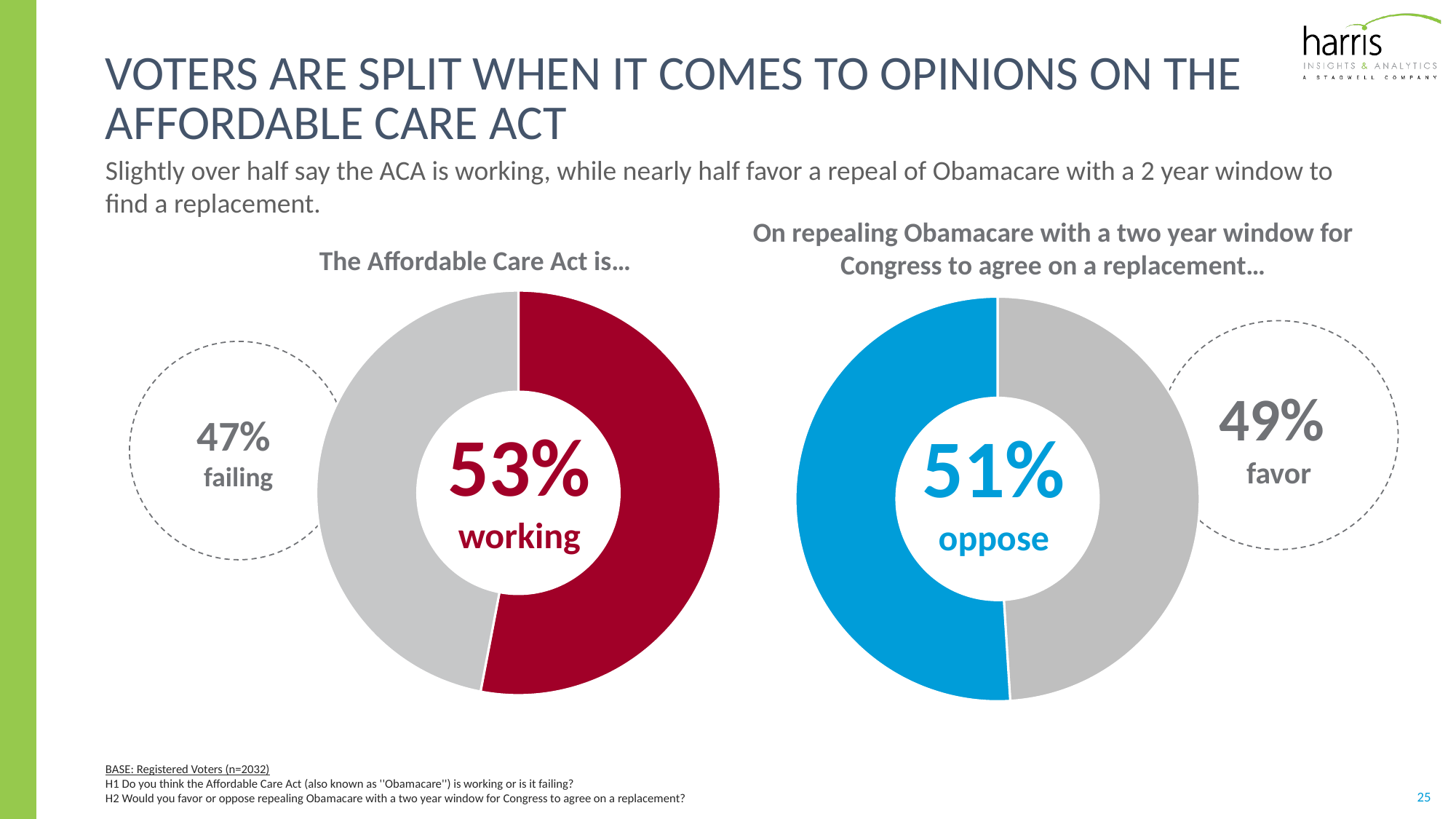
In the chart titled "The Affordable Care Act is...", what colour is the "working" slice? Dark red In the chart on repealing Obamacare with a two year window, what percentage favor? 49% In the chart on repealing Obamacare with a two year window, what percentage oppose? 51% What kind of chart is used for "The Affordable Care Act is..."? Doughnut (pie) chart In the chart on repealing Obamacare with a two year window, which response has the larger share, favor or oppose? oppose In the chart titled "The Affordable Care Act is...", what is the difference in percentage points between working and failing? 6 How many charts are shown on the slide? 2 How many slices does the chart on repealing Obamacare with a two year window have? 2 In the chart on repealing Obamacare with a two year window, what is the difference in percentage points between oppose and favor? 2 In the chart titled "The Affordable Care Act is...", what percentage say the ACA is failing? 47% In the chart titled "The Affordable Care Act is...", what percentage say the ACA is working? 53% In the chart titled "The Affordable Care Act is...", which response has the larger share, working or failing? working